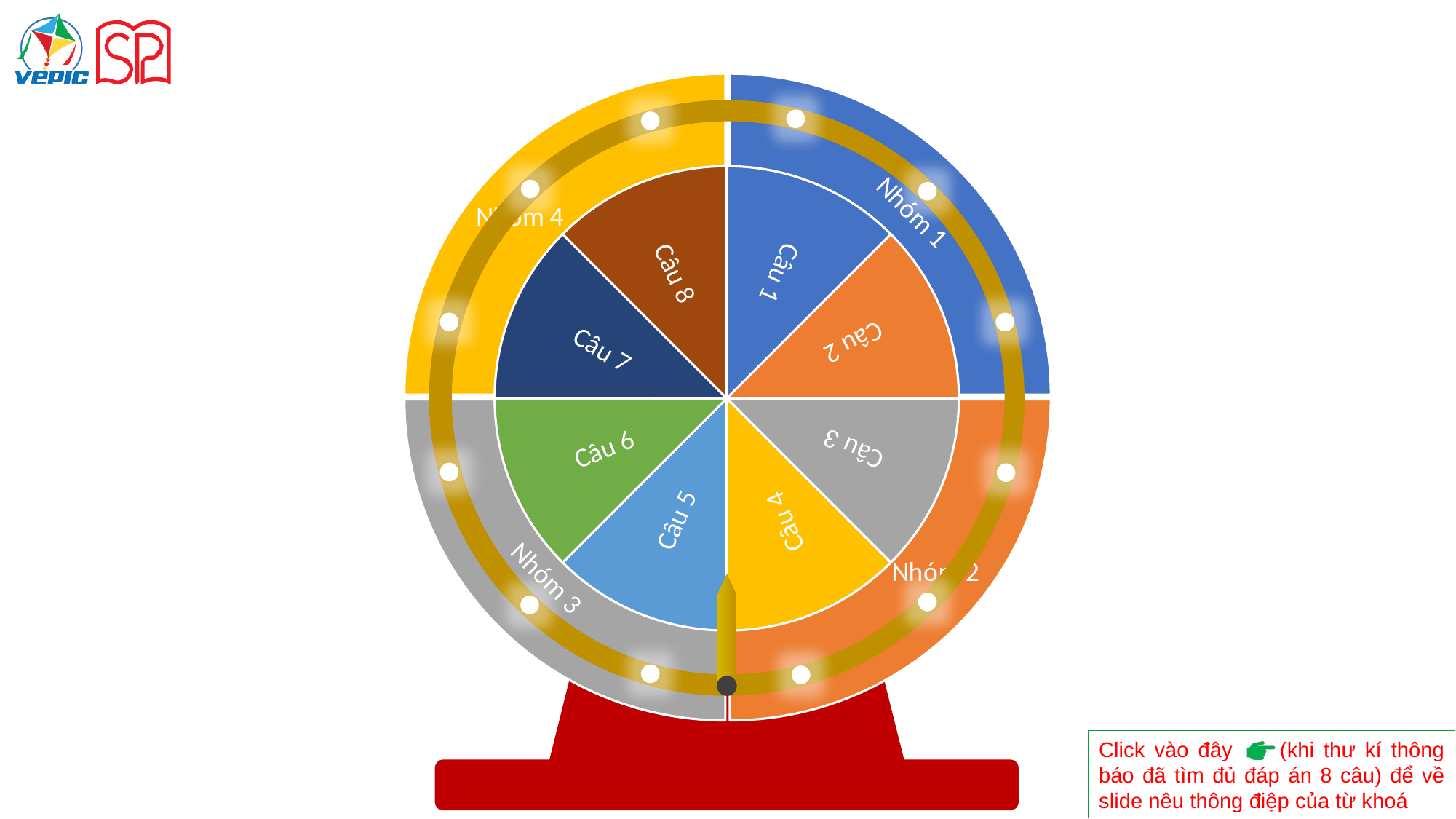
How many group segments (Nhóm) does the outer ring of the wheel contain? 4 What colour is the outer-ring section labelled Nhóm 3? Grey How many numbered question segments (Câu) does the inner wheel contain? 8 What label is shown on the brown segment of the inner wheel? Câu 8 What label is shown on the green segment of the inner wheel? Câu 6 Which outer-ring group label appears on the blue section at the top right of the wheel? Nhóm 1